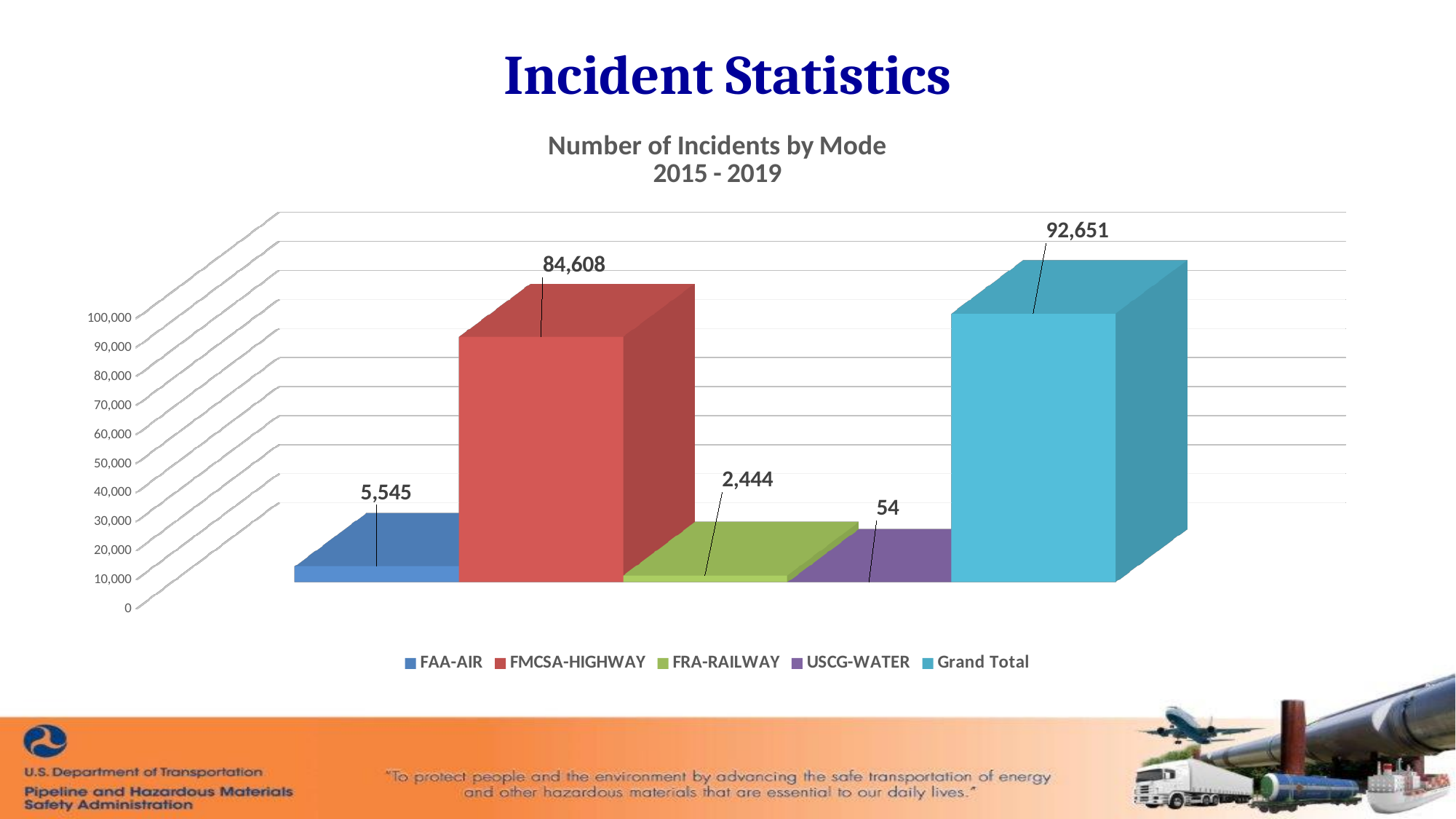
Excluding the Grand Total, which mode has the highest number of incidents? FMCSA-HIGHWAY Which mode has the lowest number of incidents? USCG-WATER What is the Grand Total of incidents shown on the chart? 92,651 What is the number of incidents for FAA-AIR? 5,545 What is the value shown for FRA-RAILWAY? 2,444 What is the number of incidents for FMCSA-HIGHWAY? 84,608 Which has more incidents, FAA-AIR or FRA-RAILWAY? FAA-AIR How many entries does the legend list? 5 What kind of chart is shown on the slide? Bar chart What is the number of incidents for USCG-WATER? 54 What is the title of the chart? Number of Incidents by Mode 2015 - 2019 What is the difference between the FMCSA-HIGHWAY and FAA-AIR incident counts? 79,063